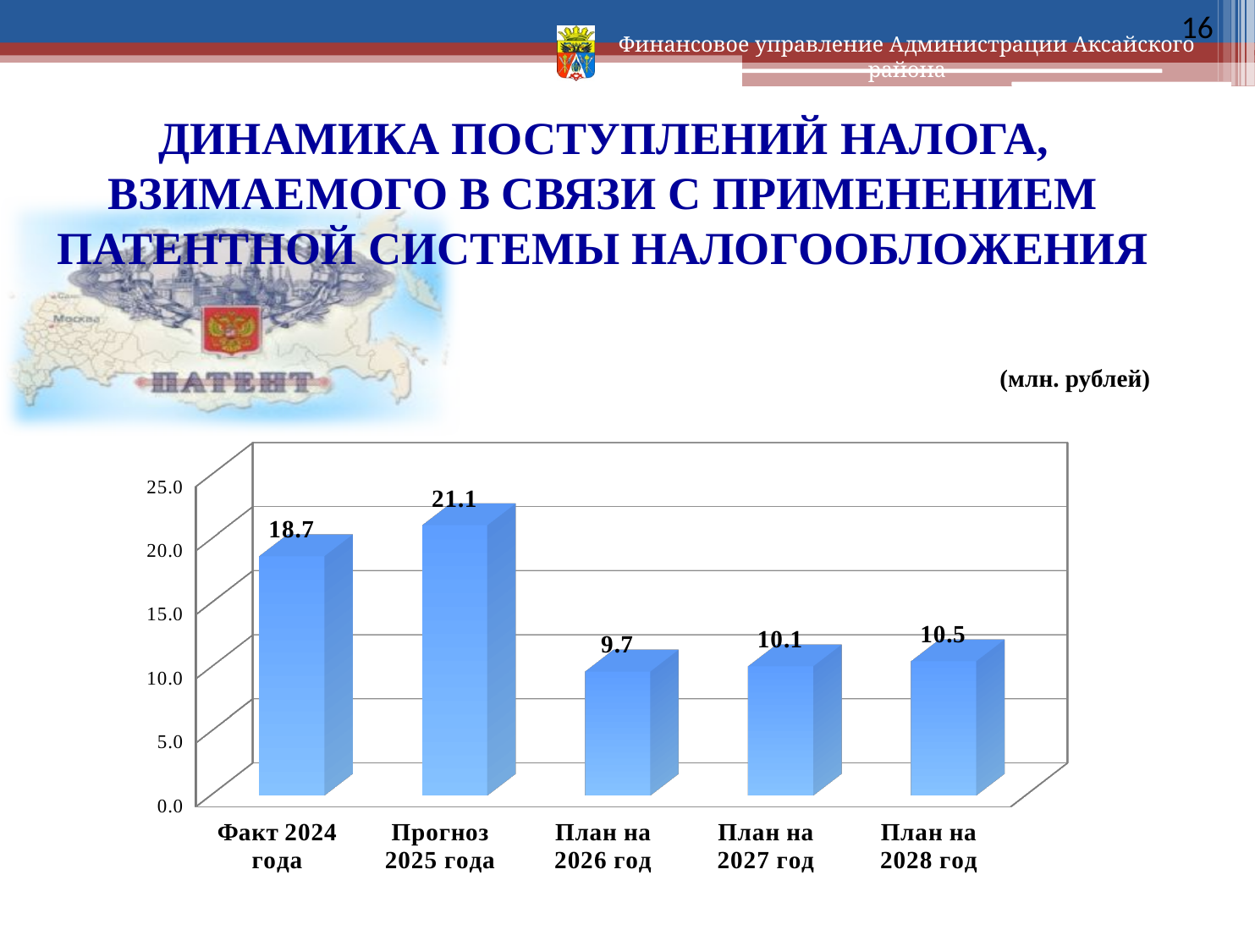
What is the value for План на 2026 год? 9.7 What kind of chart is shown on the slide? Bar chart What is the value for План на 2028 год? 10.5 Which category has the lowest value? План на 2026 год What is the difference between the values for План на 2028 год and План на 2027 год? 0.4 What is the value for Прогноз 2025 года? 21.1 Which is larger, the value for Факт 2024 года or the value for План на 2027 год? Факт 2024 года What unit is indicated for the values on the chart? млн. рублей What is the difference between the values for Прогноз 2025 года and Факт 2024 года? 2.4 Which category has the highest value? Прогноз 2025 года How many categories are shown on the chart? 5 What is the value for Факт 2024 года? 18.7